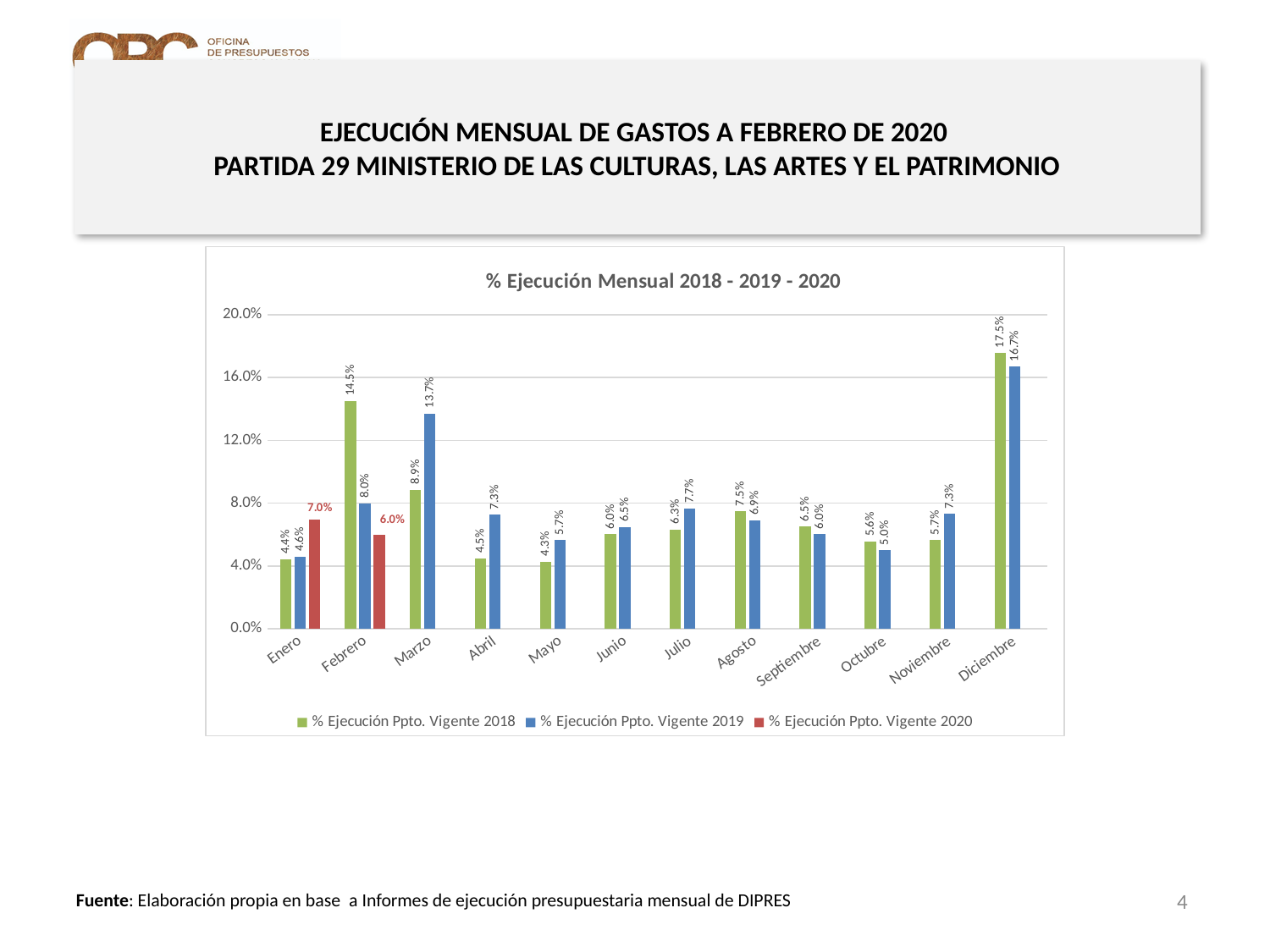
How many series does the legend list? 3 What is the value for % Ejecución Ppto. Vigente 2018 in Marzo? 8.9% How many months are shown on the x axis? 12 What is the title of the chart? % Ejecución Mensual 2018 - 2019 - 2020 What kind of chart is shown? Bar chart Which month has the lowest value for % Ejecución Ppto. Vigente 2019? Enero Which is larger in Enero: the 2020 value or the 2019 value? 2020 value (7.0%) Which month has the highest value for % Ejecución Ppto. Vigente 2018? Diciembre What is the value for % Ejecución Ppto. Vigente 2020 in Febrero? 6.0% What is the value for % Ejecución Ppto. Vigente 2019 in Diciembre? 16.7% Is the value for % Ejecución Ppto. Vigente 2019 in Marzo greater or less than 12.0%? greater What is the difference between the 2018 and 2019 values in Febrero? 6.5%